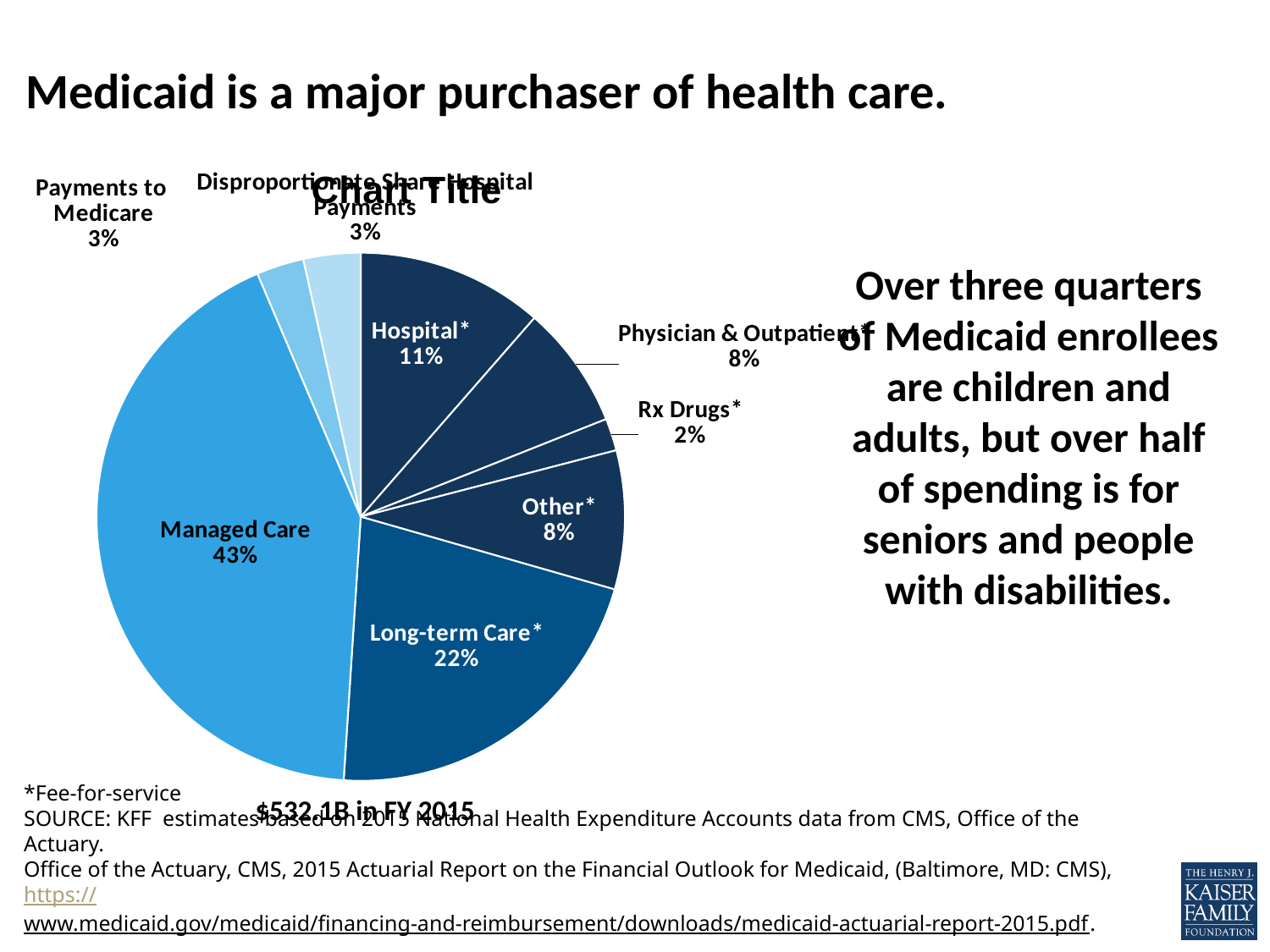
How many slices does the pie chart have? 8 What is the difference in percentage points between Managed Care and Long-term Care? 21 What is the value shown for Hospital? 11% What share of Medicaid spending goes to Managed Care? 43% What total spending amount is shown beneath the pie chart? $532.1B in FY 2015 What share is shown for Payments to Medicare? 3% What kind of chart is shown on the slide? Pie chart Which category has the largest slice of the pie? Managed Care What percentage is shown for Rx Drugs? 2% What percentage of the pie is Long-term Care? 22% Which is larger, the Hospital slice or the Physician & Outpatient slice? Hospital Which category has the smallest slice of the pie? Rx Drugs